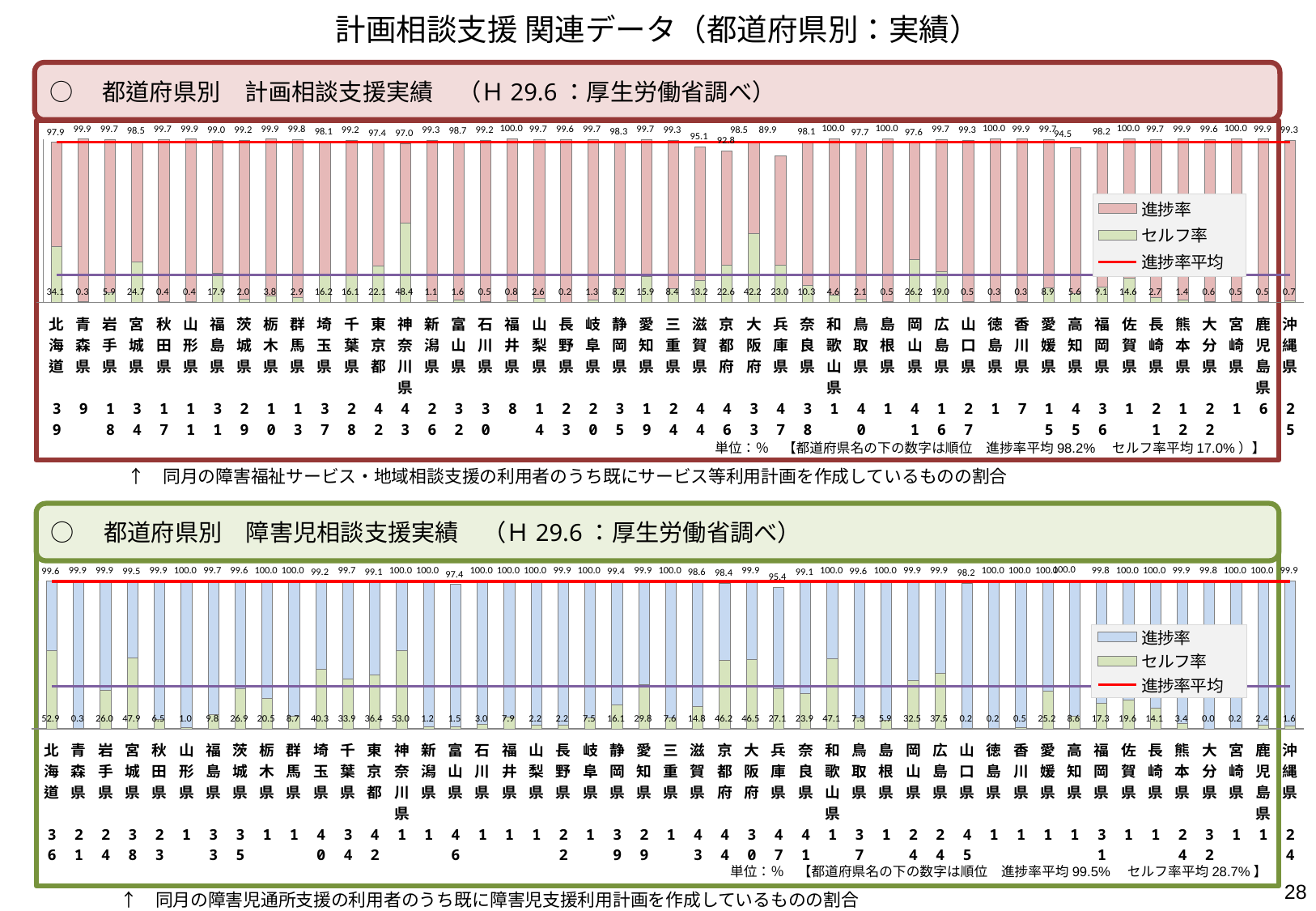
What kind of chart is the top chart (都道府県別 計画相談支援実績)? Bar chart In the top chart (都道府県別 計画相談支援実績), what is the difference between the セルフ率 of 北海道 and 青森県? 33.8 In the bottom chart (都道府県別 障害児相談支援実績), which prefecture has the lowest 進捗率? 兵庫県 In the top chart (都道府県別 計画相談支援実績), what is the セルフ率 value for 神奈川県? 48.4 In the top chart (都道府県別 計画相談支援実績), which prefecture has the lowest 進捗率? 兵庫県 How many prefectures are shown along the x axis of the bottom chart? 47 In the bottom chart (都道府県別 障害児相談支援実績), what is the セルフ率 value for 北海道? 52.9 How many entries does the legend of the top chart list? 3 In the top chart (都道府県別 計画相談支援実績), what is the 進捗率 value for 北海道? 97.9 In the top chart (都道府県別 計画相談支援実績), which prefecture has the highest セルフ率? 神奈川県 In the bottom chart (都道府県別 障害児相談支援実績), which has the higher 進捗率, 北海道 or 兵庫県? 北海道 In the bottom chart (都道府県別 障害児相談支援実績), which prefecture has the lowest セルフ率? 大分県